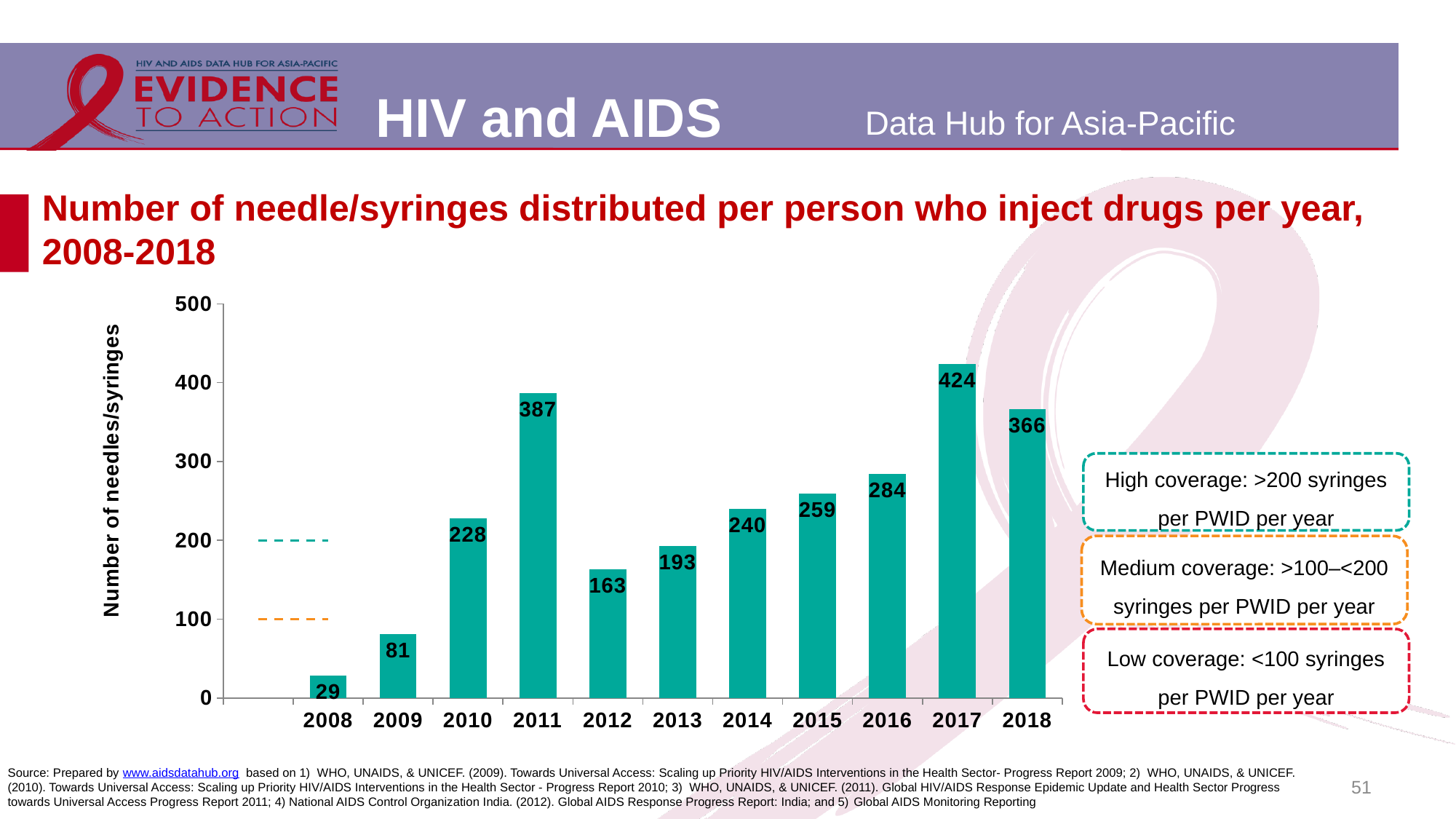
Which year has the lowest number of needles/syringes distributed per person? 2008 What is the value shown for 2008? 29 What kind of chart is shown on the slide? Bar chart Is the value for 2016 greater or less than 200? greater What is the value shown for 2018? 366 Which year has a larger value, 2013 or 2014? 2014 How many years are shown on the x axis of the chart? 11 What is the difference between the values for 2017 and 2018? 58 What is the number of needles/syringes distributed per person who injects drugs in 2011? 387 Which year has the highest number of needles/syringes distributed per person? 2017 What is the label of the y axis of the chart? Number of needles/syringes What is the difference between the values for 2011 and 2012? 224